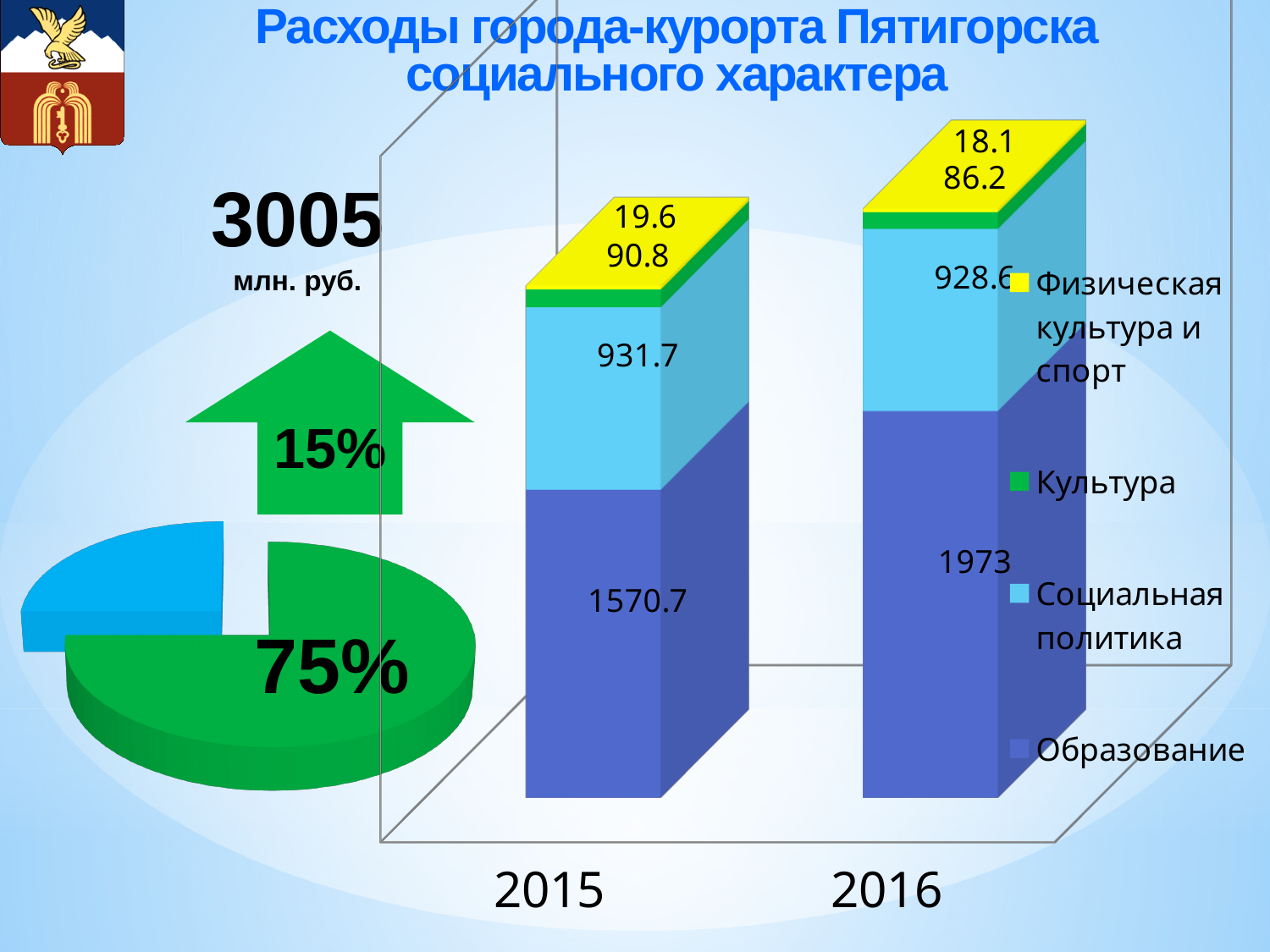
In the stacked bar chart, by how much did Образование increase from 2015 to 2016? 402.3 In the stacked bar chart, what is the value for Социальная политика in 2016? 928.6 In the stacked bar chart, which series has the smallest value in the 2015 bar? Физическая культура и спорт How many series does the legend of the stacked bar chart list? 4 How many years are shown on the x axis of the stacked bar chart? 2 What is the total of the 2015 stacked bar? 2612.8 In the stacked bar chart, which series has the largest value in the 2016 bar? Образование In the pie chart on the left of the slide, what share is shown for the green slice? 75% In the stacked bar chart, which year has the larger value for Культура, 2015 or 2016? 2015 In the stacked bar chart, what is the value for Культура in 2016? 86.2 In the stacked bar chart, what is the value for Образование in 2015? 1570.7 In the stacked bar chart, what is the value for Физическая культура и спорт in 2015? 19.6